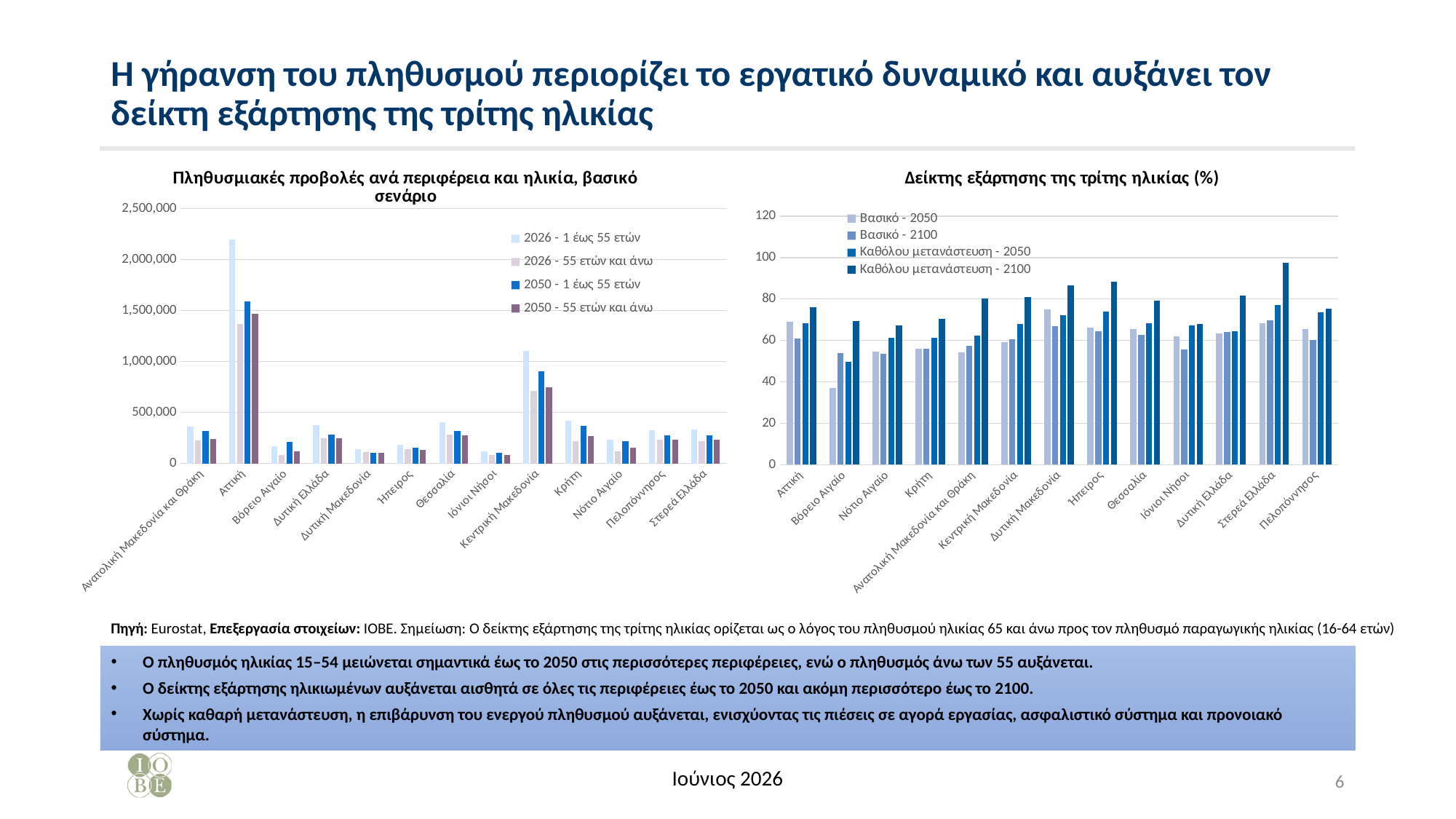
What is the title of the right chart on the slide? Δείκτης εξάρτησης της τρίτης ηλικίας (%) In the right chart, 'Δείκτης εξάρτησης της τρίτης ηλικίας (%)', which region has the highest value for the series 'Καθόλου μετανάστευση - 2100'? Στερεά Ελλάδα In the left chart, 'Πληθυσμιακές προβολές ανά περιφέρεια και ηλικία, βασικό σενάριο', which is larger for the series '2026 - 1 έως 55 ετών': Κεντρική Μακεδονία or Κρήτη? Κεντρική Μακεδονία In the right chart, 'Δείκτης εξάρτησης της τρίτης ηλικίας (%)', which region has the lowest value for the series 'Βασικό - 2050'? Βόρειο Αιγαίο In the right chart, 'Δείκτης εξάρτησης της τρίτης ηλικίας (%)', is the value for Ήπειρος in the series 'Καθόλου μετανάστευση - 2100' greater or less than 80? greater In the right chart, 'Δείκτης εξάρτησης της τρίτης ηλικίας (%)', is the value for Βόρειο Αιγαίο in the series 'Βασικό - 2050' greater or less than 40? less How many series does the legend of the right chart, 'Δείκτης εξάρτησης της τρίτης ηλικίας (%)', list? 4 In the left chart, 'Πληθυσμιακές προβολές ανά περιφέρεια και ηλικία, βασικό σενάριο', is the value for Βόρειο Αιγαίο in the series '2026 - 1 έως 55 ετών' greater or less than 500,000? less What kind of chart is the left chart, 'Πληθυσμιακές προβολές ανά περιφέρεια και ηλικία, βασικό σενάριο'? Bar chart How many regions are shown on the x axis of the left chart, 'Πληθυσμιακές προβολές ανά περιφέρεια και ηλικία, βασικό σενάριο'? 13 In the left chart, 'Πληθυσμιακές προβολές ανά περιφέρεια και ηλικία, βασικό σενάριο', which region has the highest value for the series '2026 - 1 έως 55 ετών'? Αττική